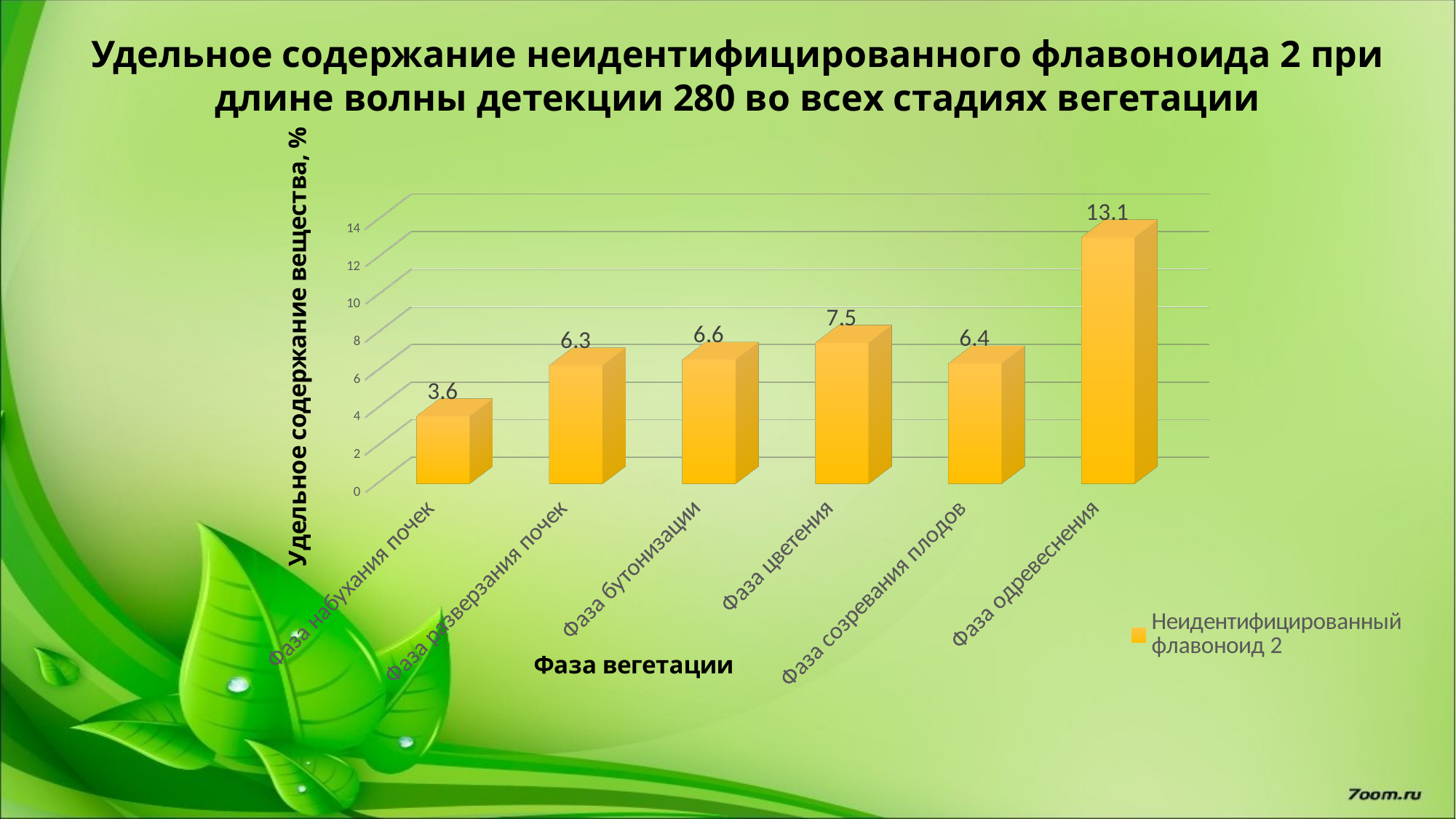
What kind of chart is shown on the slide? Bar chart How many series does the legend list? 1 Which vegetation phase has the lowest value? Фаза набухания почек What is the value for Фаза цветения? 7.5 What is the difference between the values for Фаза одревеснения and Фаза набухания почек? 9.5 Which is larger, the value for Фаза цветения or the value for Фаза бутонизации? Фаза цветения Which vegetation phase has the highest value? Фаза одревеснения How many vegetation phases are shown on the x axis? 6 What is the label of the x axis? Фаза вегетации What is the value for Фаза набухания почек? 3.6 What is the value for Фаза одревеснения? 13.1 What is the value for Фаза созревания плодов? 6.4